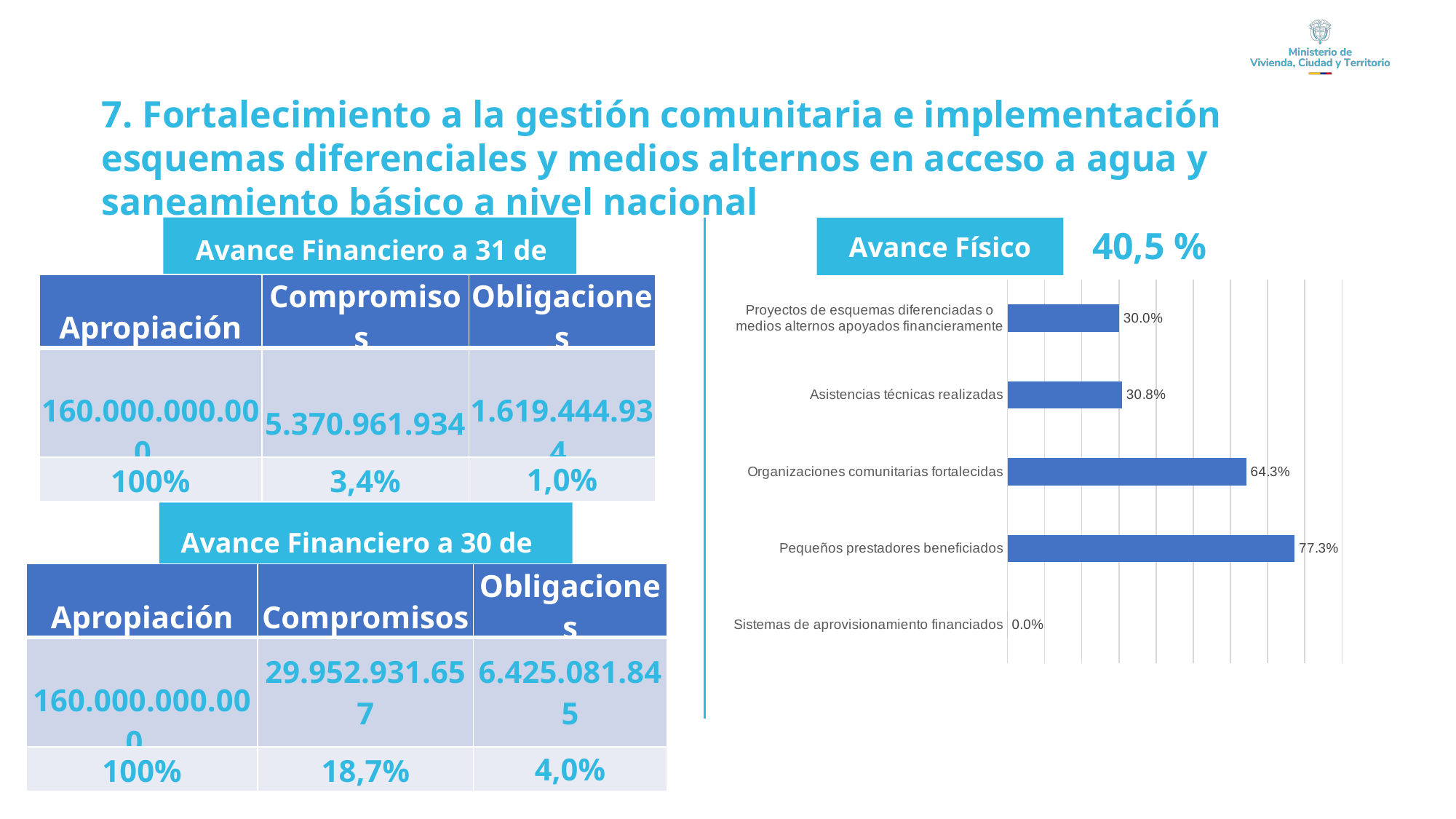
In the Avance Físico chart, which is larger: Organizaciones comunitarias fortalecidas or Pequeños prestadores beneficiados? Pequeños prestadores beneficiados What is the value for Sistemas de aprovisionamiento financiados in the Avance Físico chart? 0.0% Which category has the highest value in the Avance Físico chart? Pequeños prestadores beneficiados What is the value for Pequeños prestadores beneficiados in the Avance Físico chart? 77.3% What is the value for Asistencias técnicas realizadas in the Avance Físico chart? 30.8% In the Avance Físico chart, what is the difference between Asistencias técnicas realizadas and Proyectos de esquemas diferenciadas o medios alternos apoyados financieramente? 0.8% What is the value for Organizaciones comunitarias fortalecidas in the Avance Físico chart? 64.3% How many categories are shown in the Avance Físico chart? 5 Which category has the lowest value in the Avance Físico chart? Sistemas de aprovisionamiento financiados In the Avance Físico chart, what is the difference between Pequeños prestadores beneficiados and Organizaciones comunitarias fortalecidas? 13.0% What is the value for Proyectos de esquemas diferenciadas o medios alternos apoyados financieramente in the Avance Físico chart? 30.0% What type of chart is the Avance Físico chart? Bar chart